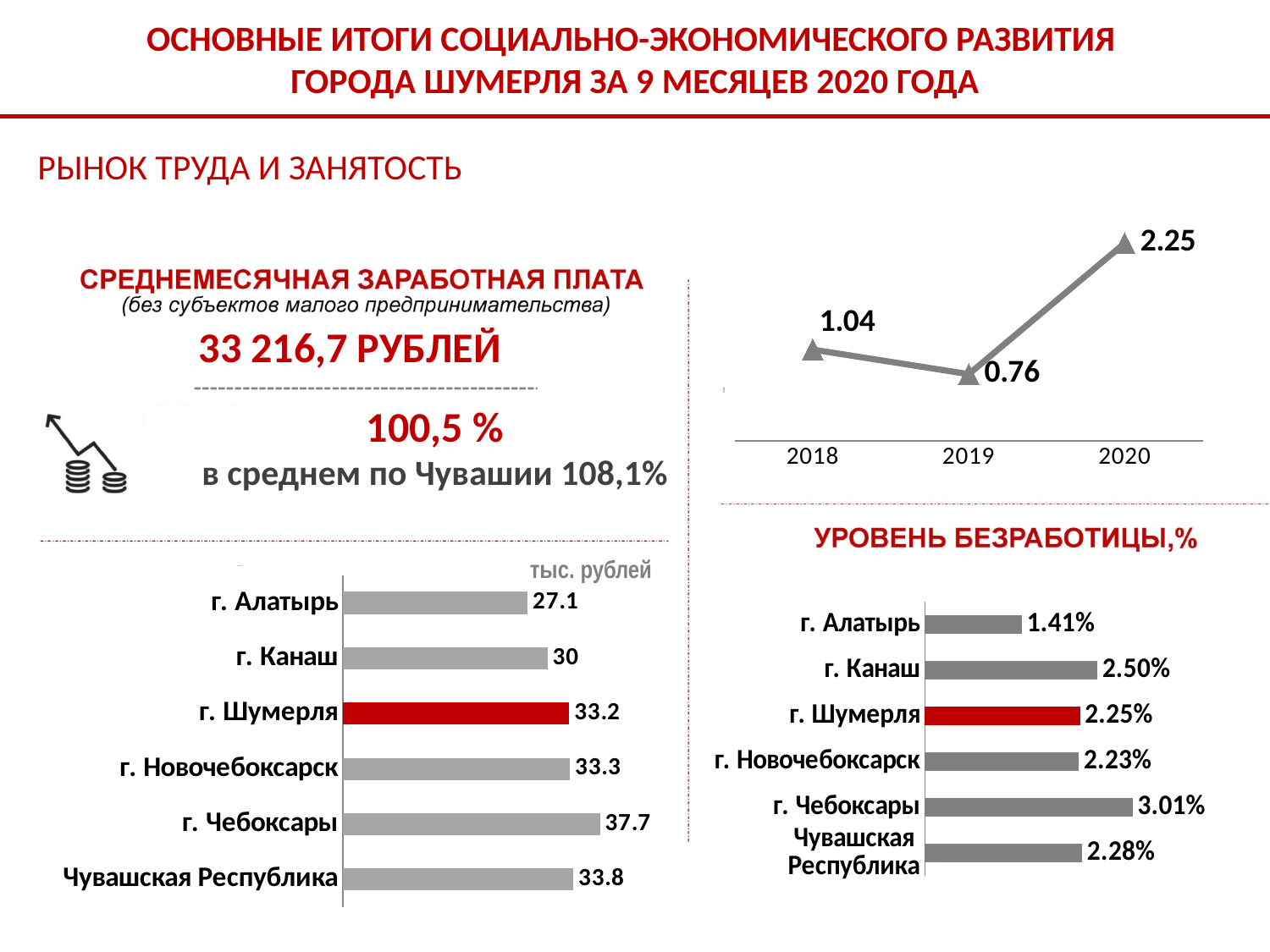
In the bar chart at the bottom left (тыс. рублей), what is the value for г. Шумерля? 33.2 In the bar chart at the bottom left (тыс. рублей), what is the difference between г. Чебоксары and г. Алатырь? 10.6 In the bar chart at the bottom right (УРОВЕНЬ БЕЗРАБОТИЦЫ,%), which category has the lowest value? г. Алатырь In the line chart at the top right, what is the value for 2019? 0.76 In the bar chart at the bottom right (УРОВЕНЬ БЕЗРАБОТИЦЫ,%), which is larger: г. Канаш or Чувашская Республика? г. Канаш What type of chart is shown at the top right of the slide? line chart In the bar chart at the bottom left (тыс. рублей), how many categories are shown? 6 In the bar chart at the bottom left (тыс. рублей), which category has the lowest value? г. Алатырь In the bar chart at the bottom left (тыс. рублей), which category has the highest value? г. Чебоксары In the bar chart at the bottom right (УРОВЕНЬ БЕЗРАБОТИЦЫ,%), which category has the highest value? г. Чебоксары In the bar chart at the bottom right (УРОВЕНЬ БЕЗРАБОТИЦЫ,%), what is the value for г. Канаш? 2.50% In the line chart at the top right, what is the difference between the 2020 and 2018 values? 1.21